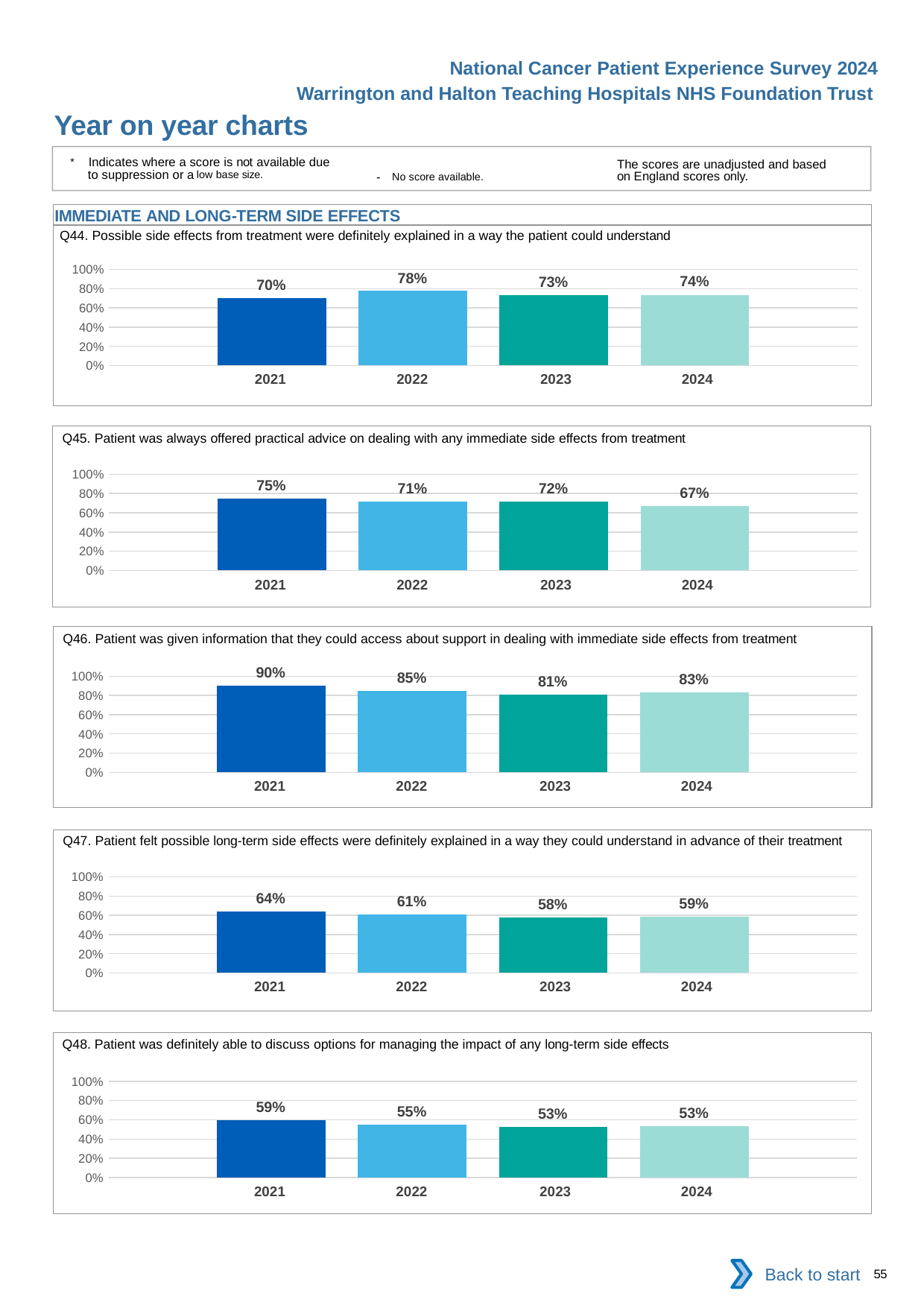
In the Q47 chart, is the value for 2023 greater or less than 60%? less In the Q44 chart, what is the value for 2022? 78% What type of chart is used for Q46? Bar chart In the Q46 chart, what is the difference between the 2021 and 2023 values? 9 percentage points In the Q48 chart, do the values rise or fall from 2021 to 2023? Fall In the Q44 chart, how many years are plotted? 4 In the Q48 chart, what is the value for 2024? 53% In the Q47 chart, which year has the highest value? 2021 In the Q46 chart, what is the value for 2024? 83% In the Q45 chart, which year has the lowest value? 2024 In the Q45 chart, is the value for 2022 or 2023 larger? 2023 What is the section heading above the Q44 chart? IMMEDIATE AND LONG-TERM SIDE EFFECTS